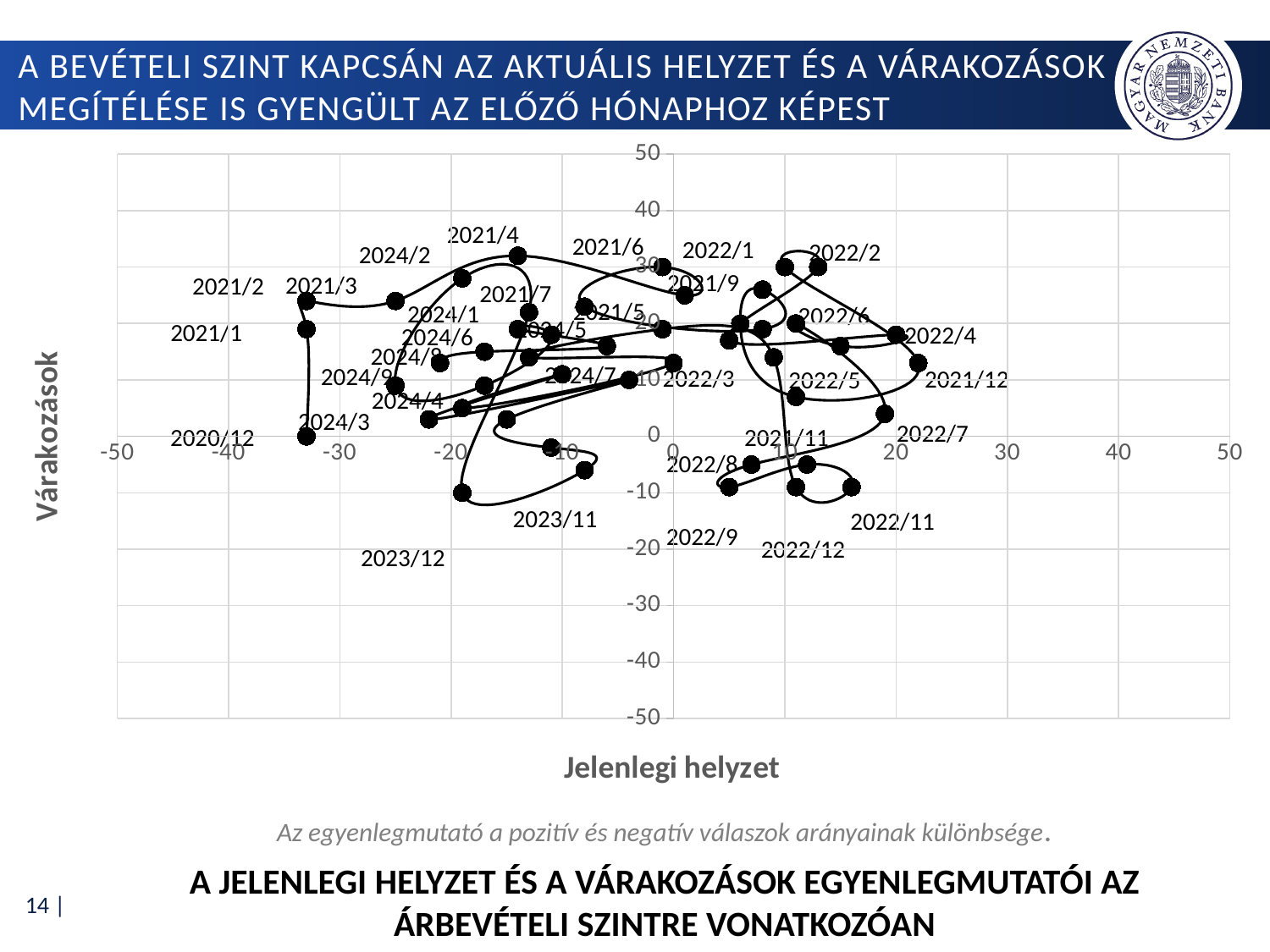
Which point has the higher Várakozások value, 2022/2 or 2020/12? 2022/2 Is the Várakozások value for the point labelled 2020/12 greater or less than 10? less What is the title of the vertical axis of the chart? Várakozások What kind of chart is shown on the slide? scatter chart Which point has the higher Jelenlegi helyzet value, 2022/2 or 2021/1? 2022/2 Is the Várakozások value for the point labelled 2022/2 greater or less than 20? greater Is the Jelenlegi helyzet value for the point labelled 2022/11 greater or less than 10? greater What is the title of the horizontal axis of the chart? Jelenlegi helyzet What is the maximum value shown on the vertical axis of the chart? 50